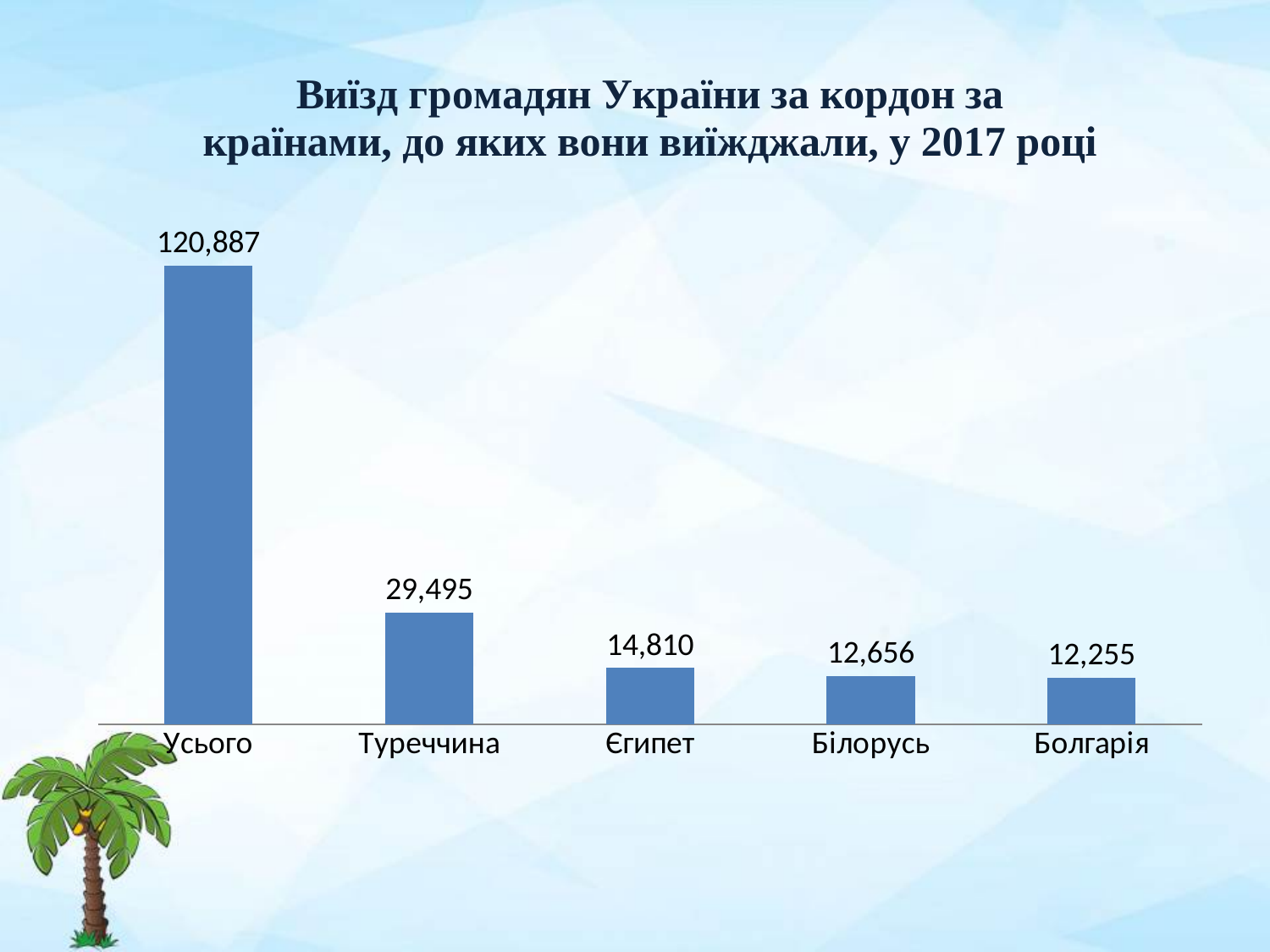
What is the difference between the values for Туреччина and Єгипет? 14,685 What is the value for Єгипет? 14,810 Which category has the lowest value? Болгарія Which category has the highest value? Усього What is the value for Білорусь? 12,656 Which is larger, the value for Туреччина or the value for Єгипет? Туреччина What type of chart is shown on the slide? bar chart What is the difference between the values for Білорусь and Болгарія? 401 What is the value for Усього? 120,887 What is the value for Болгарія? 12,255 What is the value for Туреччина? 29,495 How many categories are shown on the x axis? 5